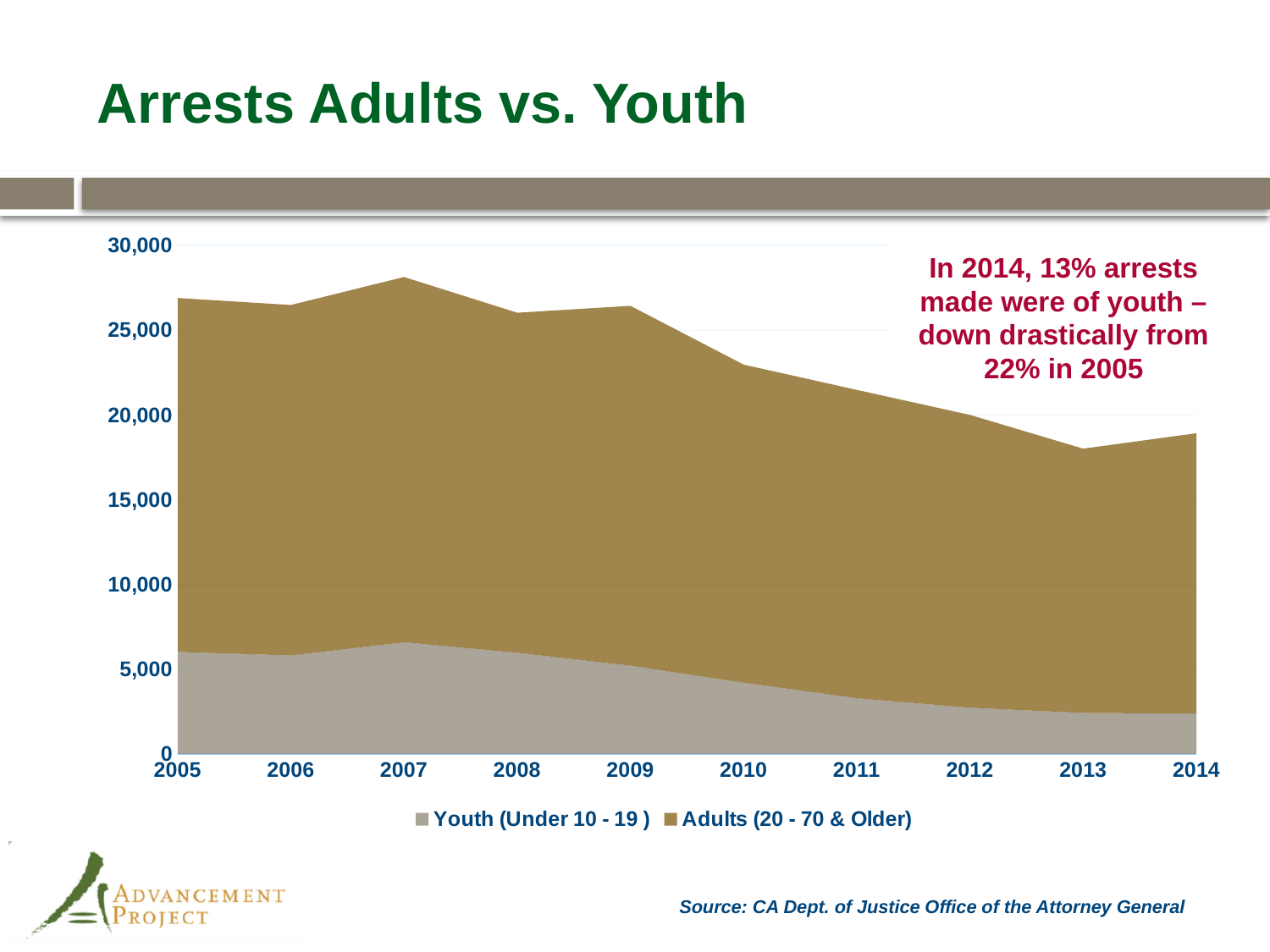
Is the value for Youth (Under 10 - 19) in 2014 greater or less than 5,000? less Which series is shown in the darker gold colour? Adults (20 - 70 & Older) Which is larger, the Youth (Under 10 - 19) value in 2005 or in 2014? 2005 How many years are plotted along the x axis? 10 What is the title of the chart? Arrests Adults vs. Youth Is the total of the stacked areas in 2007 greater or less than 25,000? greater Is the total of the stacked areas in 2014 greater or less than 20,000? less How many series does the legend list? 2 In which year is the total of the stacked areas highest? 2007 What kind of chart is shown on the slide? Stacked area chart Does the Youth (Under 10 - 19) series rise or fall from 2007 to 2014? fall